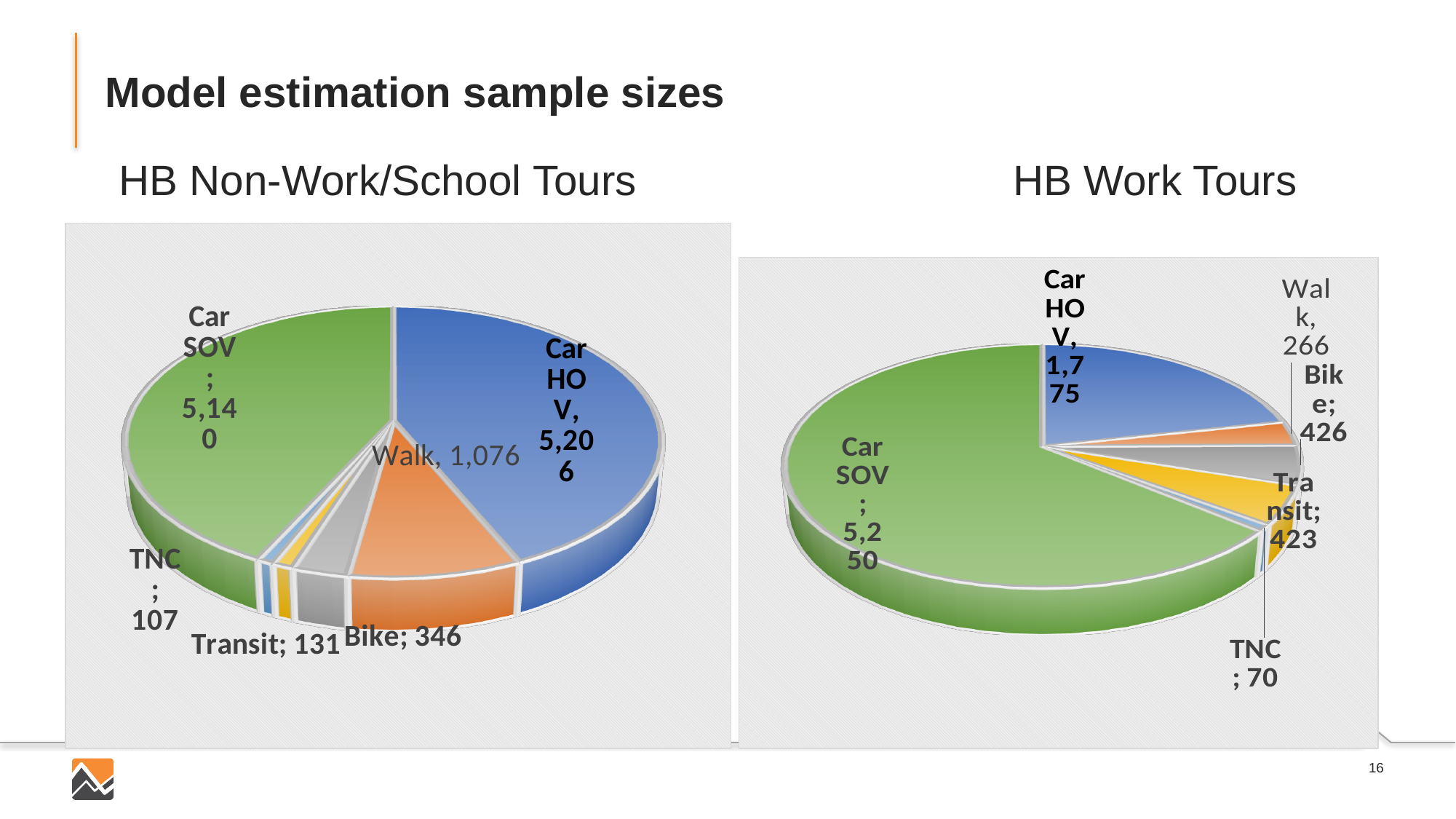
In the HB Non-Work/School Tours chart, which category has the smallest value? TNC In the HB Work Tours chart, what is the value for TNC? 70 What is the title of the slide? Model estimation sample sizes In the HB Work Tours chart, what is the value for Car SOV? 5,250 In the HB Non-Work/School Tours chart, which category has the largest value? Car HOV How many categories are shown in the HB Non-Work/School Tours chart? 6 In the HB Work Tours chart, what is the difference between Car SOV and Car HOV? 3,475 In the HB Work Tours chart, which is larger, Bike or Transit? Bike What kind of chart is used for HB Non-Work/School Tours? Pie chart In the HB Non-Work/School Tours chart, what is the difference between Car HOV and Car SOV? 66 In the HB Non-Work/School Tours chart, what is the value for Car HOV? 5,206 In the HB Non-Work/School Tours chart, what is the value for Walk? 1,076